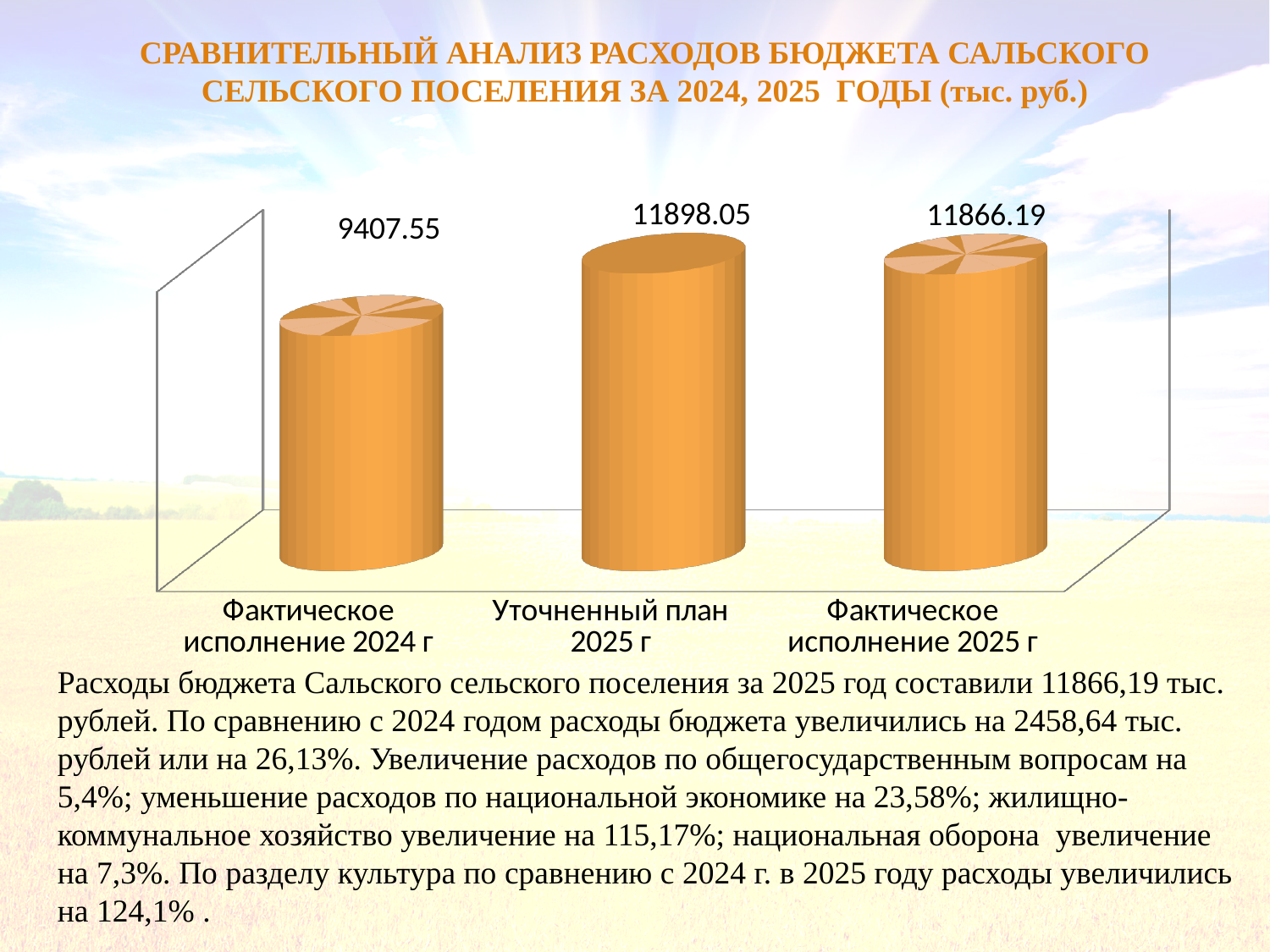
What is the value for Фактическое исполнение 2024 г? 9407.55 What is the difference between Уточненный план 2025 г and Фактическое исполнение 2025 г? 31.86 Which is larger: Фактическое исполнение 2024 г or Уточненный план 2025 г? Уточненный план 2025 г What is the value for Фактическое исполнение 2025 г? 11866.19 What is the value for Уточненный план 2025 г? 11898.05 How many categories are shown in the chart? 3 What is the difference between Уточненный план 2025 г and Фактическое исполнение 2024 г? 2490.50 Which is larger: Фактическое исполнение 2024 г or Фактическое исполнение 2025 г? Фактическое исполнение 2025 г Which category has the lowest value? Фактическое исполнение 2024 г What unit of measurement is stated in the slide title? тыс. руб. What is the difference between Фактическое исполнение 2025 г and Фактическое исполнение 2024 г? 2458.64 What kind of chart is shown on the slide? Bar chart